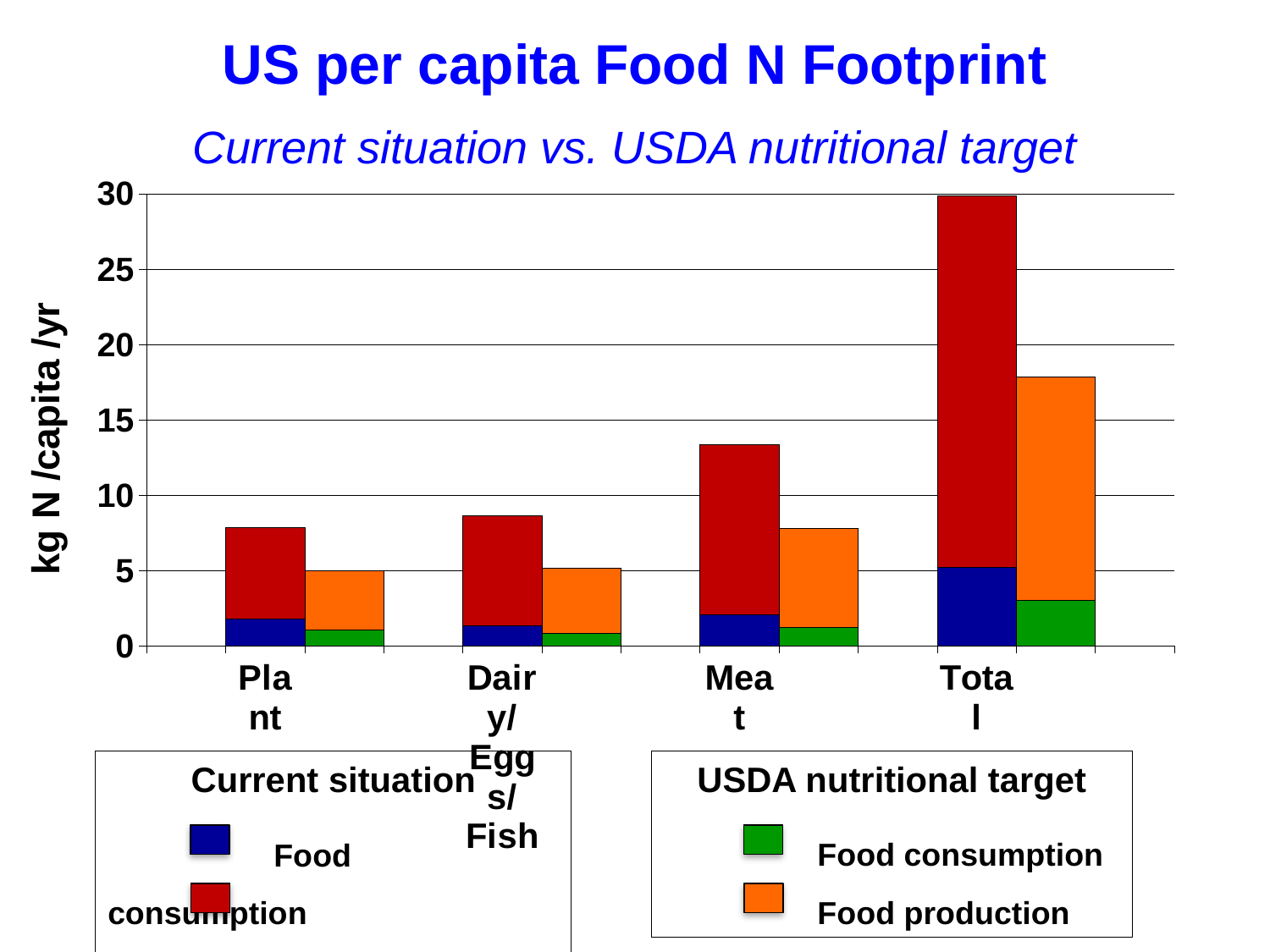
How many categories are shown on the x axis? 4 Among Plant, Dairy/Eggs/Fish and Meat, which has the tallest 'Current situation' stacked bar? Meat Is the total of the 'USDA nutritional target' stacked bar for Total greater or less than 15? greater Is the total of the 'Current situation' stacked bar for Total greater or less than 25? greater What is the label on the y axis? kg N /capita /yr Do the 'Current situation' stacked bar totals rise or fall from Plant to Total along the x axis? Rise Which category has the tallest 'Current situation' stacked bar? Total What kind of chart is shown on the slide? Stacked bar chart How many entries does the 'USDA nutritional target' legend list? 2 Is the total of the 'USDA nutritional target' stacked bar for Meat greater or less than 10? less For Meat, which stacked bar is taller: 'Current situation' or 'USDA nutritional target'? Current situation